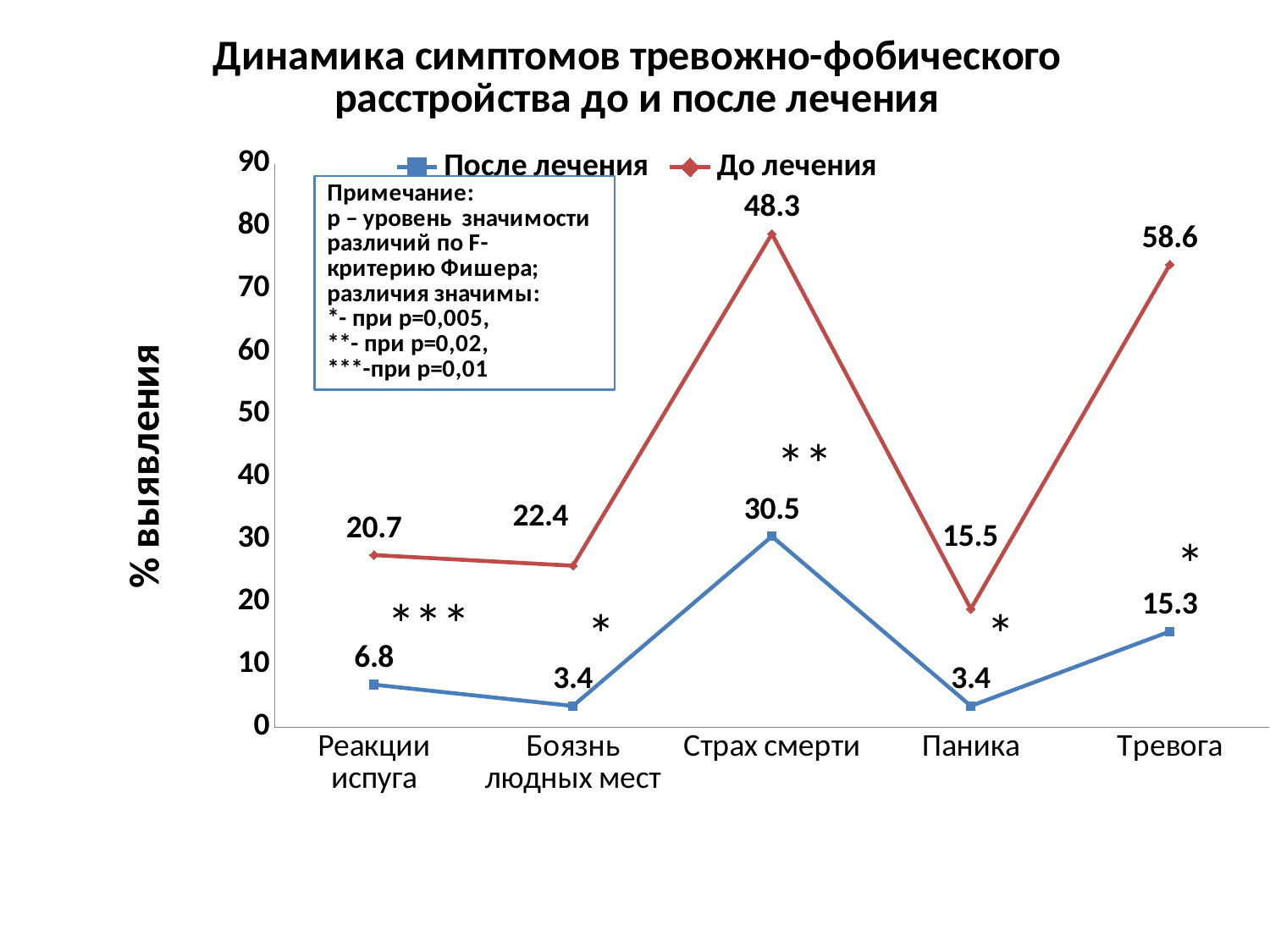
What type of chart is shown on the slide? line chart How many series does the legend list? 2 What is the value for 'Реакции испуга' in the 'До лечения' series? 20.7 What is the label of the y axis? % выявления What is the value for 'Паника' in the 'После лечения' series? 3.4 How many symptom categories are shown on the x axis? 5 Which category has the lowest value in the 'До лечения' series? Паника Which category has the highest value in the 'После лечения' series? Страх смерти What is the value for 'Тревога' in the 'После лечения' series? 15.3 What is the value for 'Страх смерти' in the 'До лечения' series? 48.3 What is the difference between the 'До лечения' and 'После лечения' values for 'Страх смерти'? 17.8 For 'Паника', which series has the larger value, 'До лечения' or 'После лечения'? До лечения